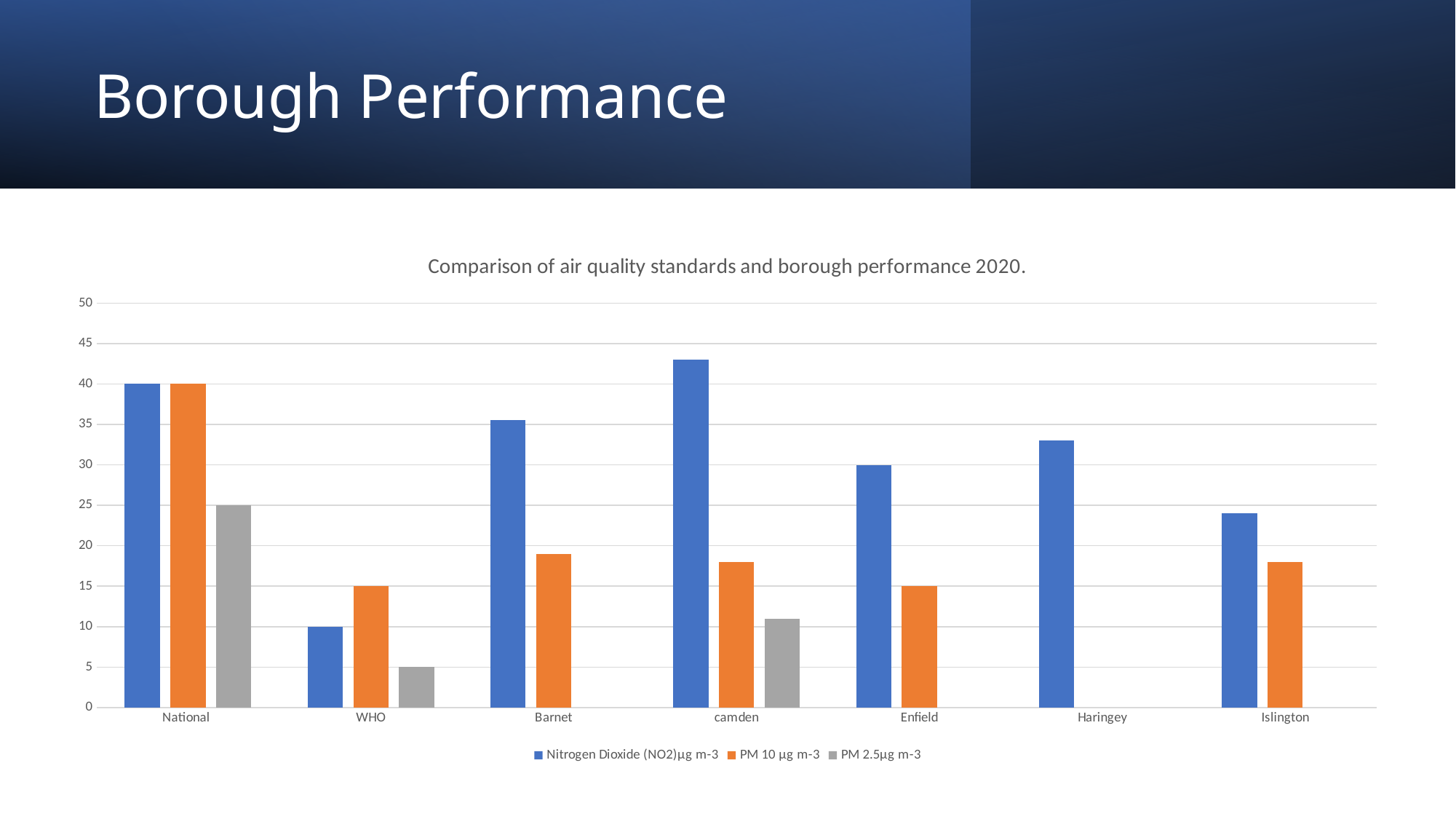
What is the Nitrogen Dioxide (NO2) value for National? 40 How many series does the legend list? 3 Is the Nitrogen Dioxide (NO2) value for camden greater or less than 40? greater How many categories are shown on the x axis? 7 What is the PM 2.5 value for WHO? 5 What is the title of the chart? Comparison of air quality standards and borough performance 2020. Which category has the lowest Nitrogen Dioxide (NO2) value? WHO Which is larger, the Nitrogen Dioxide (NO2) value for Barnet or for Enfield? Barnet Which category has the highest Nitrogen Dioxide (NO2) value? camden What is the PM 10 value for Enfield? 15 What type of chart is shown on the slide? Bar chart Is the Nitrogen Dioxide (NO2) value for Haringey greater or less than 35? less